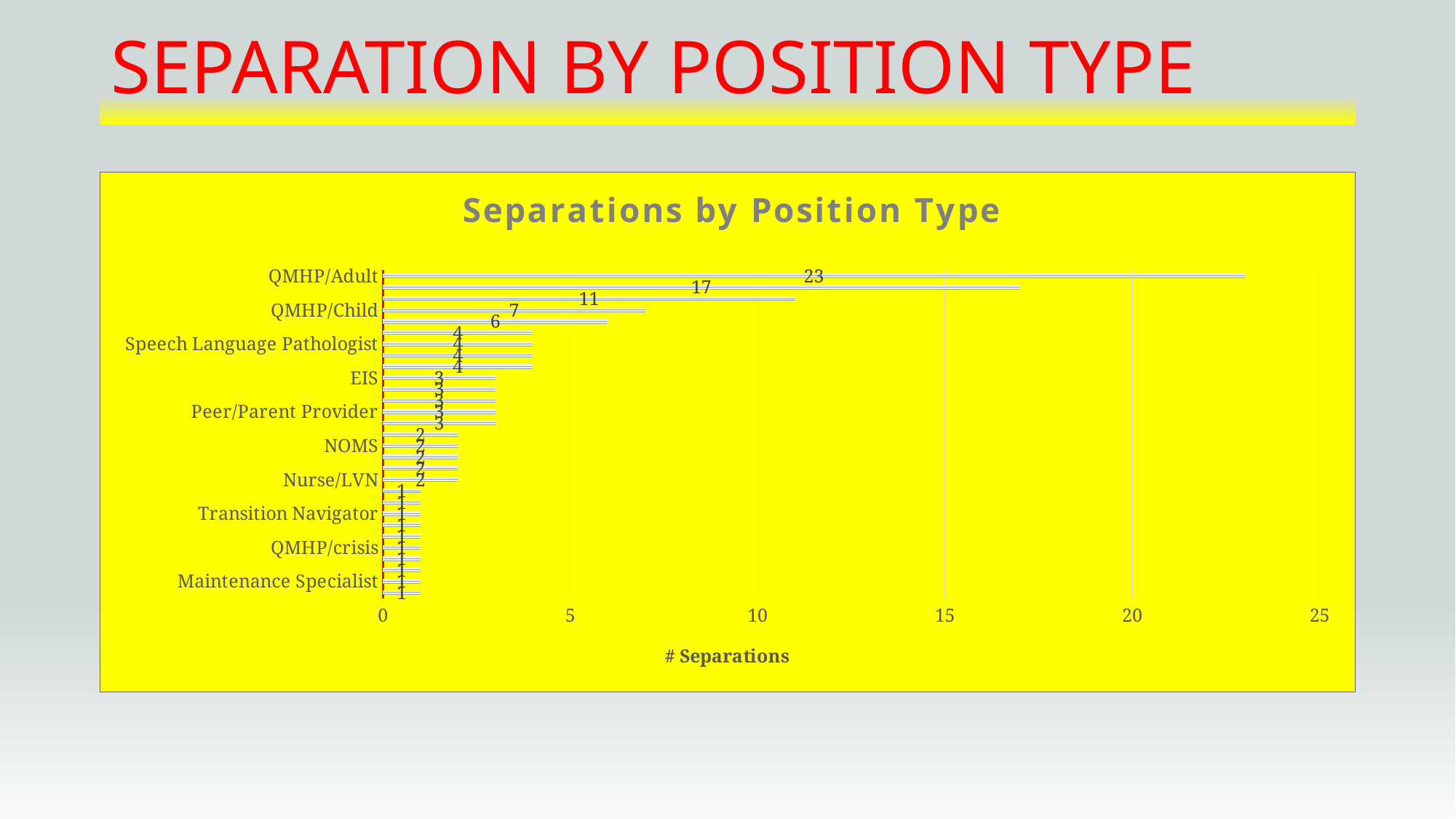
What is the difference in separations between QMHP/Adult and QMHP/Child? 16 What is the label on the horizontal axis of the chart? # Separations How many separations are shown for EIS? 3 Is the value for QMHP/Adult greater or less than 20? greater How many separations are shown for Maintenance Specialist? 1 How many separations are shown for QMHP/Child? 7 What type of chart is shown on the slide? bar chart What is the title of the chart? Separations by Position Type How many separations are shown for Speech Language Pathologist? 4 Which has more separations, QMHP/Adult or QMHP/Child? QMHP/Adult Which position type has the highest number of separations? QMHP/Adult How many separations are shown for QMHP/Adult? 23